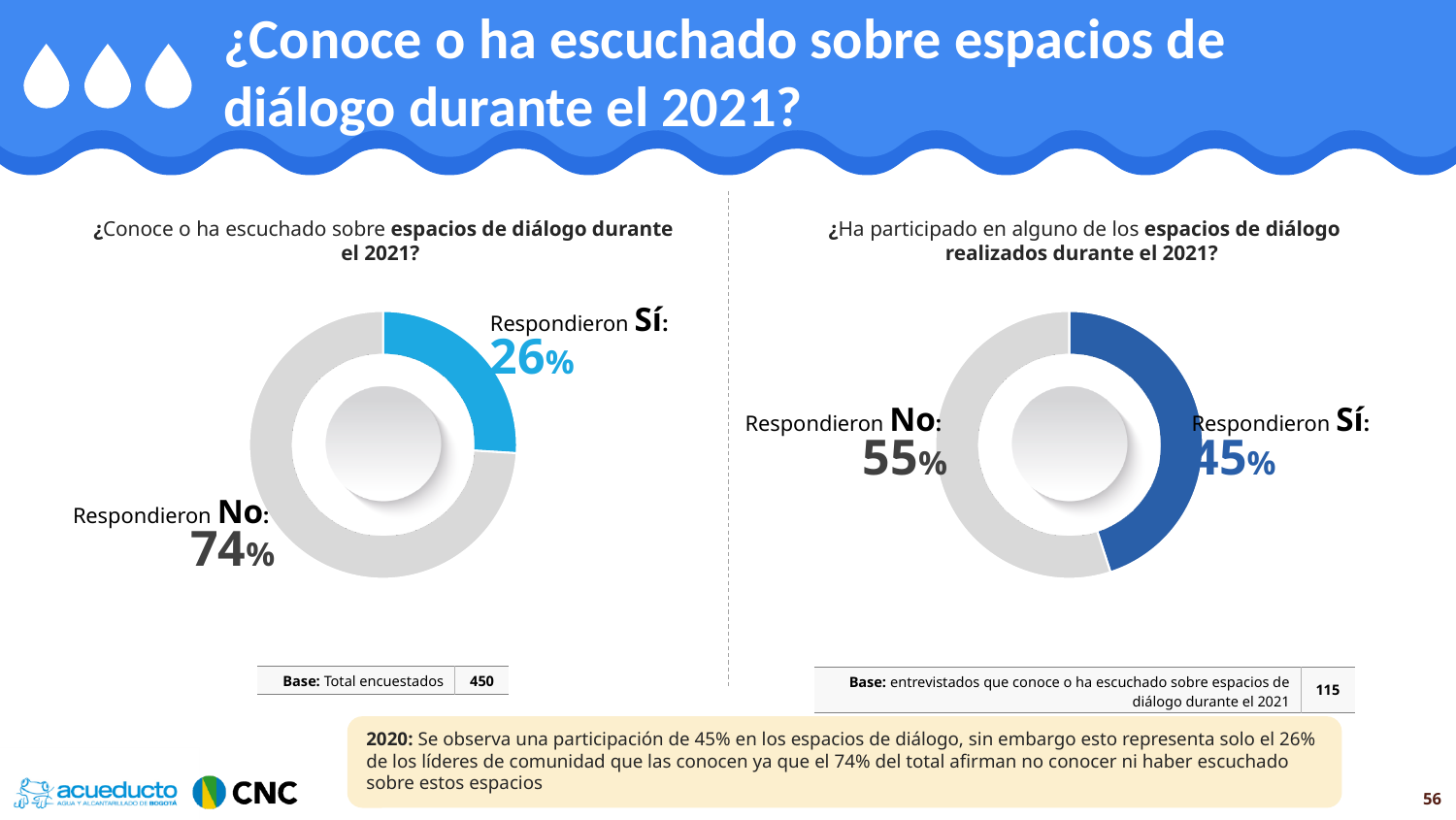
In the left chart, what is the difference in percentage points between the No and Sí responses? 48 What is the base (number of respondents) for the right chart? 115 In the left chart (¿Conoce o ha escuchado sobre espacios de diálogo durante el 2021?), what percentage responded No? 74% How many response categories are shown in the right chart? 2 In the right chart (¿Ha participado en alguno de los espacios de diálogo realizados durante el 2021?), what percentage responded Sí? 45% In the left chart (¿Conoce o ha escuchado sobre espacios de diálogo durante el 2021?), what percentage responded Sí? 26% In the right chart (¿Ha participado en alguno de los espacios de diálogo realizados durante el 2021?), what percentage responded No? 55% In the right chart, which response has the larger share, Sí or No? No What is the base (number of respondents) for the left chart? 450 What type of chart is used on the left side of the slide? Donut (pie) chart In the left chart, which response has the larger share, Sí or No? No In the right chart, what is the difference in percentage points between the No and Sí responses? 10